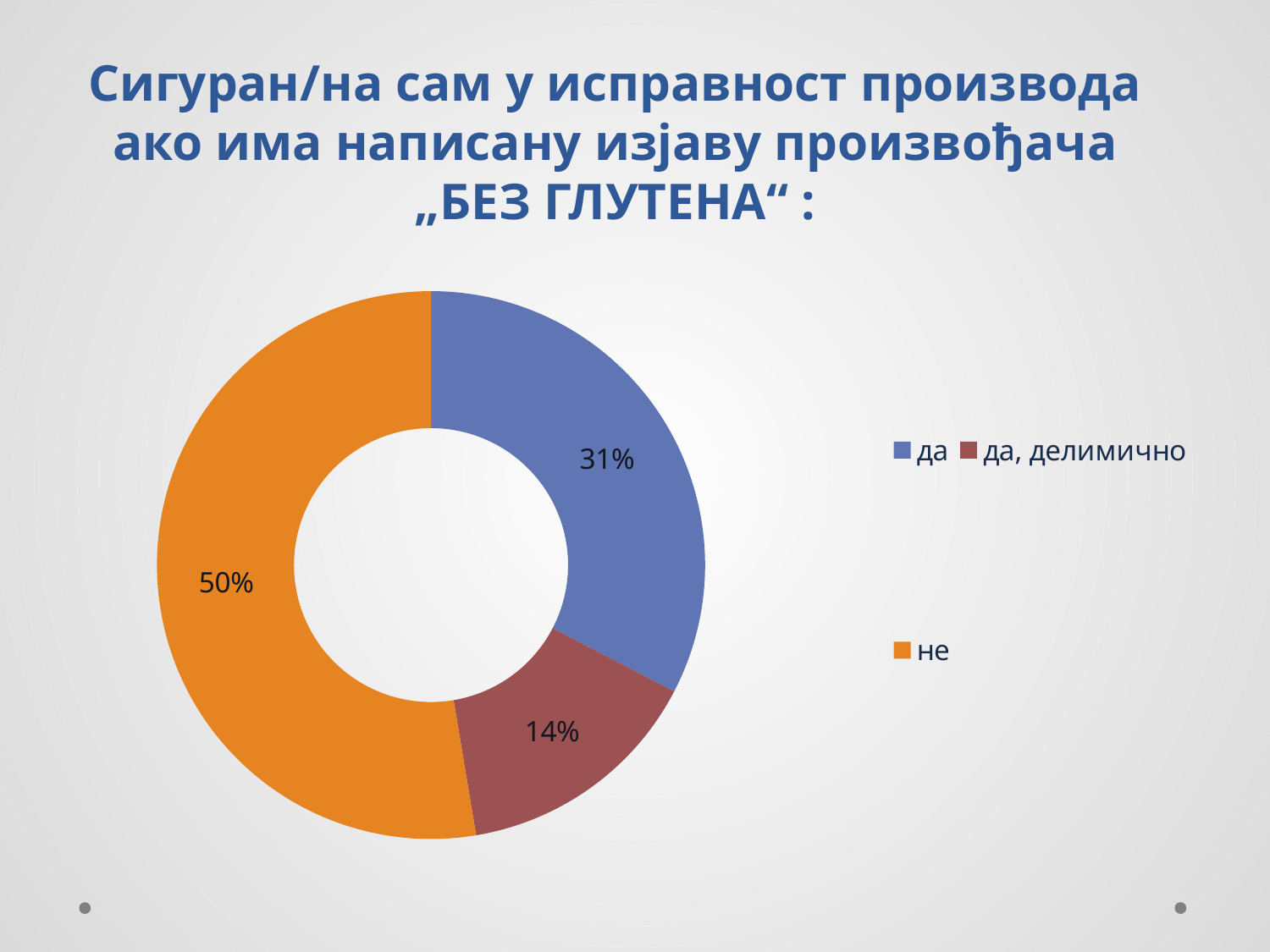
What colour is the "не" slice? Orange How many entries does the legend list? 3 What kind of chart is shown on the slide? Doughnut (pie) chart What percentage is shown for the "да, делимично" slice? 14% What percentage is shown for the "да" slice? 31% What percentage is shown for the "не" slice? 50% Which category has the smallest share of the chart? да, делимично What is the difference in percentage points between the "не" slice and the "да" slice? 19 What is the difference in percentage points between the "да" slice and the "да, делимично" slice? 17 How many slices does the chart have? 3 Which category has the largest share of the chart? не Which is larger, the "да" slice or the "да, делимично" slice? да